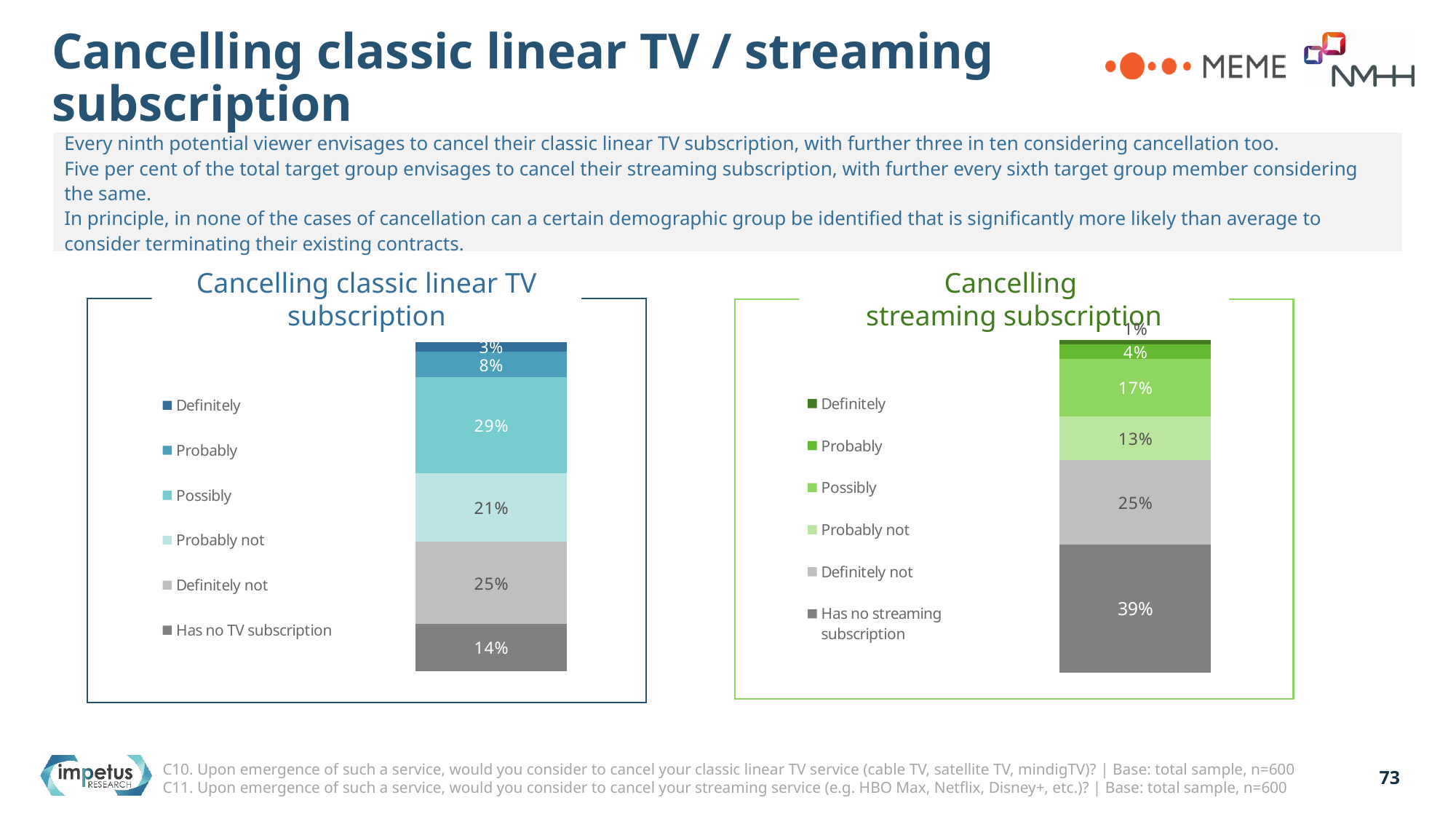
In the 'Cancelling streaming subscription' chart, what percentage has no streaming subscription? 39% In the 'Cancelling classic linear TV subscription' chart, what percentage answered 'Possibly'? 29% What kind of chart is the 'Cancelling classic linear TV subscription' chart? Stacked bar chart In the 'Cancelling streaming subscription' chart, what is the difference between 'Has no streaming subscription' and 'Definitely not'? 14 percentage points In the 'Cancelling streaming subscription' chart, what percentage answered 'Probably not'? 13% In the 'Cancelling classic linear TV subscription' chart, what is the combined share of 'Definitely' and 'Probably'? 11% In the 'Cancelling classic linear TV subscription' chart, what percentage has no TV subscription? 14% How many series does the legend of the 'Cancelling streaming subscription' chart list? 6 In the 'Cancelling streaming subscription' chart, which response has the smallest share? Definitely Which is larger: 'Probably' in the 'Cancelling classic linear TV subscription' chart or 'Probably' in the 'Cancelling streaming subscription' chart? Cancelling classic linear TV subscription In the 'Cancelling classic linear TV subscription' chart, which response has the largest share? Possibly In the 'Cancelling classic linear TV subscription' chart, what is the difference between 'Possibly' and 'Probably not'? 8 percentage points